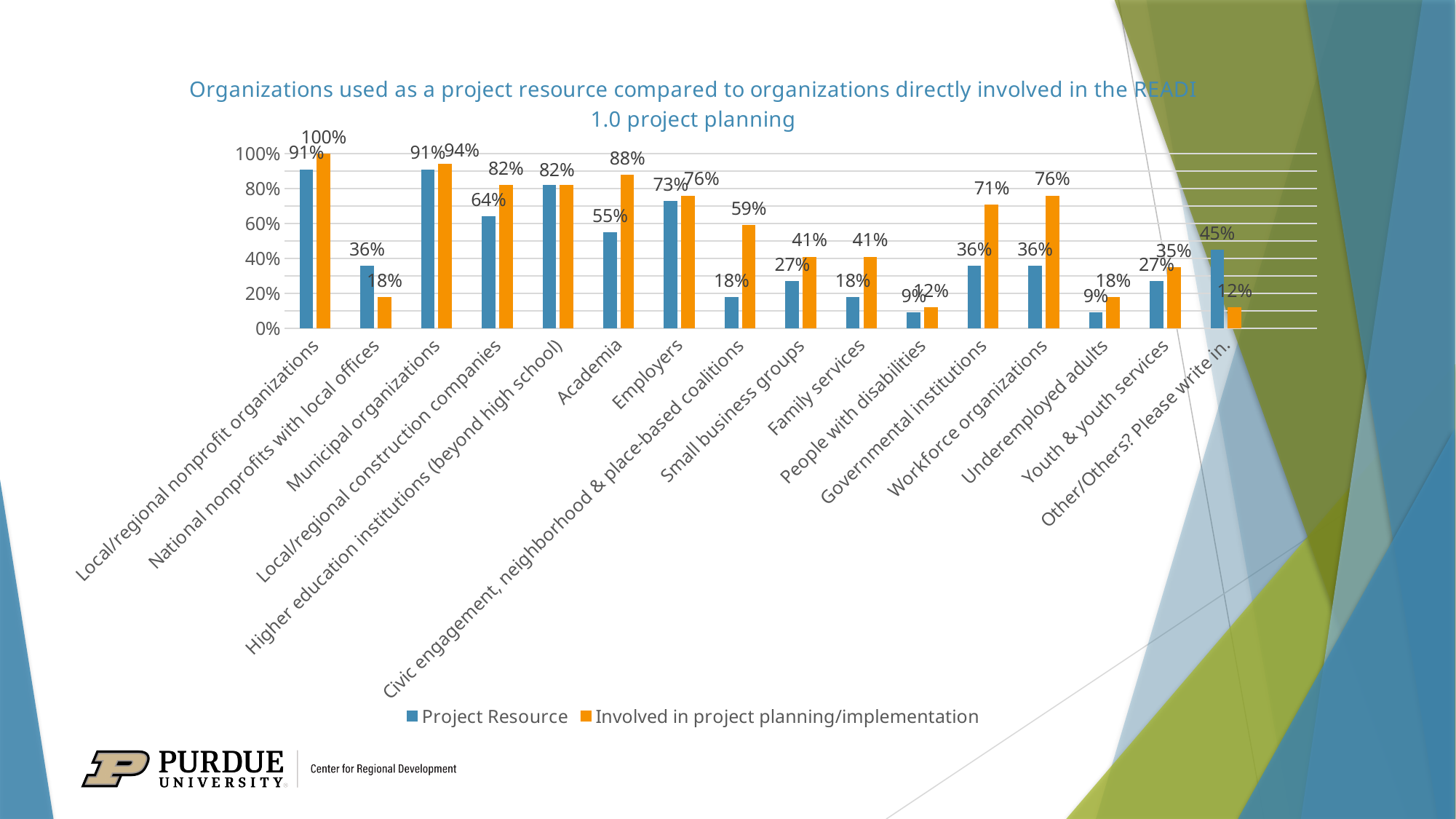
What is the Project Resource value for Local/regional construction companies? 64% What is the Project Resource value for Academia? 55% Is the Involved in project planning/implementation value for Workforce organizations greater or less than 60%? greater What kind of chart is shown on the slide? Bar chart Which category has the lowest Involved in project planning/implementation value? People with disabilities and Other/Others? Please write in. (both 12%) What is the difference between the Involved in project planning/implementation value and the Project Resource value for Civic engagement, neighborhood & place-based coalitions? 41% How many series does the legend list? 2 Which category has the highest Involved in project planning/implementation value? Local/regional nonprofit organizations What is the Involved in project planning/implementation value for Governmental institutions? 71% For National nonprofits with local offices, which series has the larger value: Project Resource or Involved in project planning/implementation? Project Resource How many categories are shown on the x axis? 16 Which colour represents the Involved in project planning/implementation series? Orange